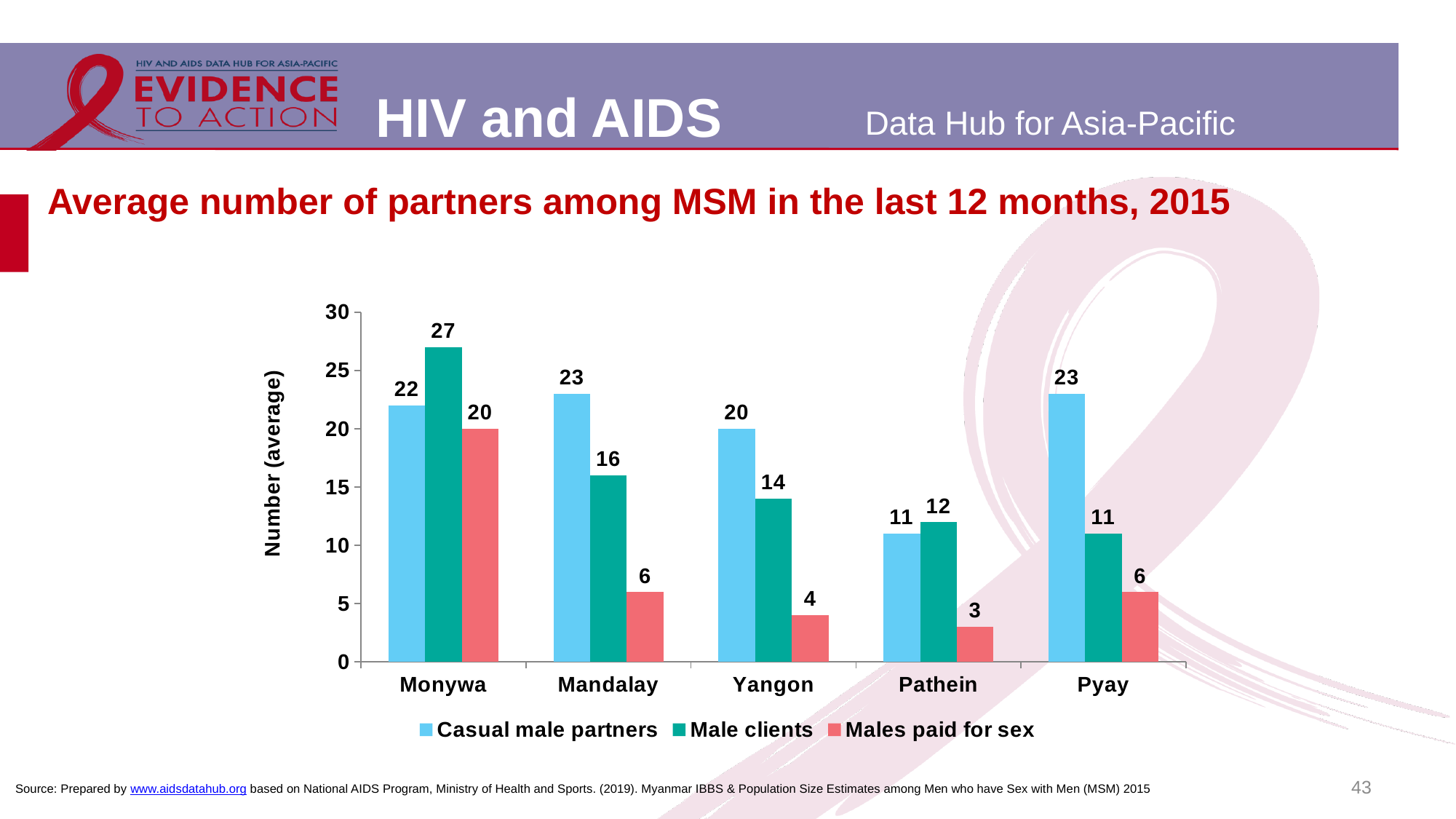
What kind of chart is shown on the slide? Bar chart What is the label of the y axis? Number (average) What is the average number of casual male partners among MSM in Pyay? 23 What is the average number of males paid for sex among MSM in Pathein? 3 What is the average number of male clients among MSM in Monywa? 27 How many cities are shown on the x axis? 5 How many series does the legend list? 3 Which city has the lowest average number of casual male partners? Pathein Which city has the highest average number of males paid for sex? Monywa In Pathein, which is larger: the average number of casual male partners or male clients? Male clients What is the difference between the average number of casual male partners and male clients in Mandalay? 7 What is the title of the chart? Average number of partners among MSM in the last 12 months, 2015